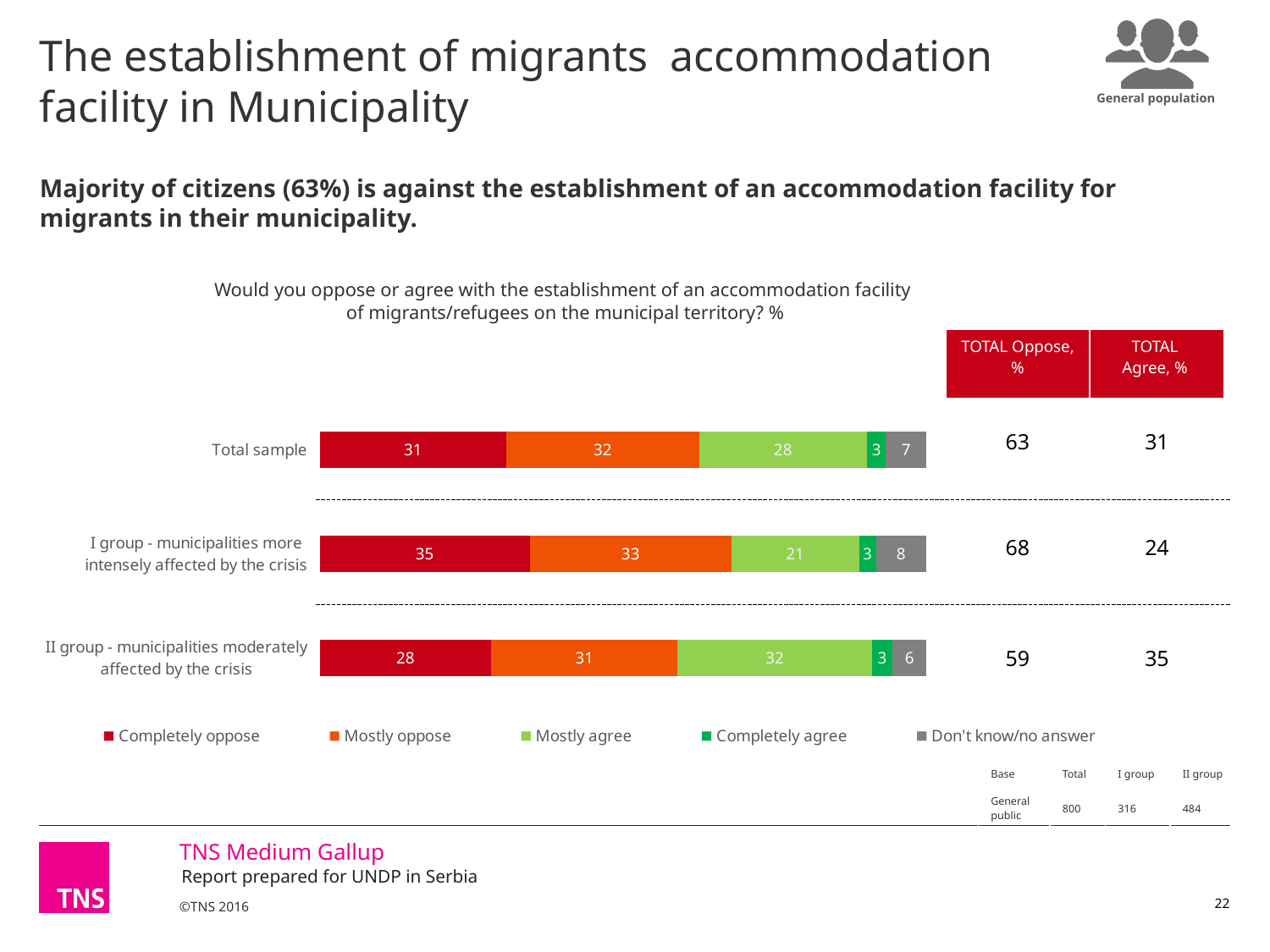
How many categories (bars) are shown in the chart? 3 What is the value for "Mostly agree" in the "I group - municipalities more intensely affected by the crisis" bar? 21 What is the value for "Completely oppose" in the Total sample bar? 31 What is the total of the "Completely oppose" and "Mostly oppose" segments for the Total sample bar? 63 Which is larger: the "Mostly agree" value for the Total sample or for the II group? II group What colour represents "Completely agree" in the legend? Green Which category has the lowest "Mostly agree" value? I group - municipalities more intensely affected by the crisis What kind of chart is shown on the slide? Stacked bar chart What is the value for "Don't know/no answer" in the "II group - municipalities moderately affected by the crisis" bar? 6 Which category has the highest "Completely oppose" value? I group - municipalities more intensely affected by the crisis What is the difference between the "Mostly oppose" values for the I group and the II group? 2 How many series does the legend list? 5